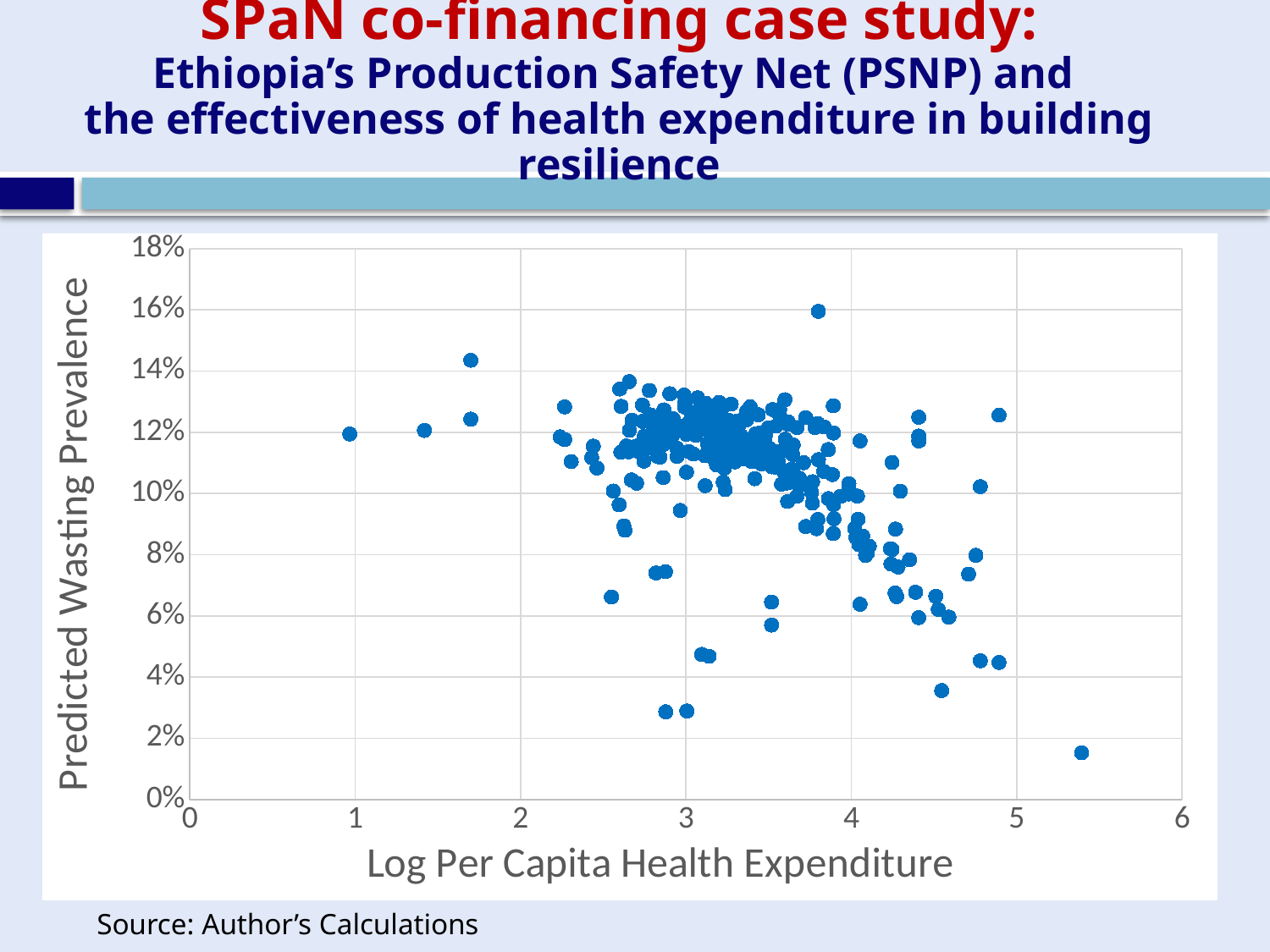
What is the title of the y axis of the chart? Predicted Wasting Prevalence Is the Predicted Wasting Prevalence of the highest point on the chart greater or less than 14%? greater Is the Log Per Capita Health Expenditure of the point with the lowest Predicted Wasting Prevalence greater or less than 5? greater As Log Per Capita Health Expenditure increases along the x axis, does Predicted Wasting Prevalence generally rise or fall? Fall Is the Predicted Wasting Prevalence of the lowest point on the chart greater or less than 2%? less Which has the higher Predicted Wasting Prevalence: the leftmost point on the chart or the rightmost point? The leftmost point What is the title of the x axis of the chart? Log Per Capita Health Expenditure What kind of chart is shown on the slide? Scatter plot